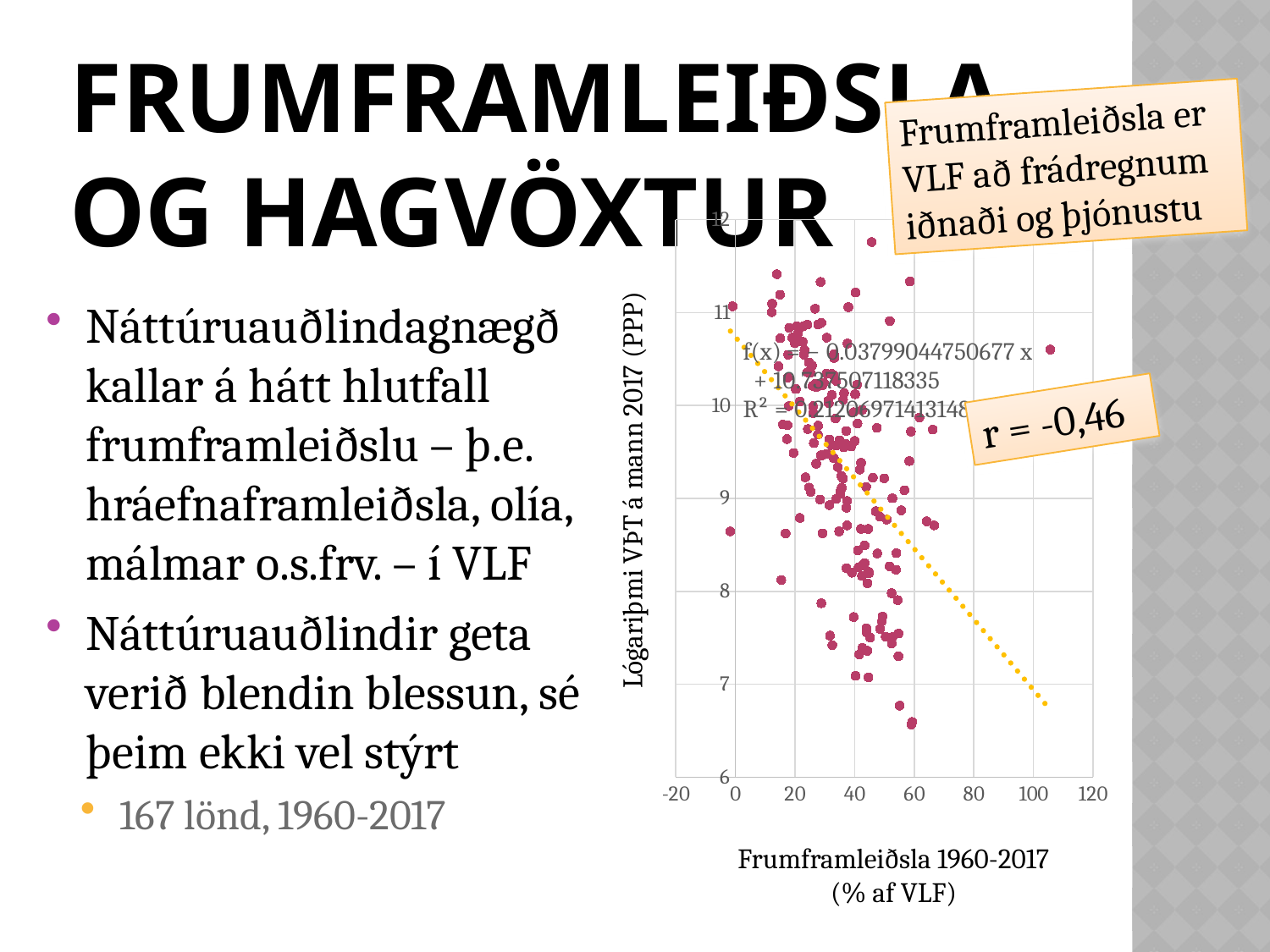
Is the y-axis value of the lowest plotted point greater or less than 7? less What kind of chart is shown on the slide? scatter chart Is the x-axis value of the rightmost plotted point greater or less than 80? greater What correlation coefficient r is shown on the slide for the chart? r = -0,46 What is the slope coefficient of x in the fitted line equation f(x) shown on the chart? -0.03799044750677 Is the y-axis value of the highest plotted point greater or less than 11? greater Do the plotted values tend to rise or fall as the x-axis value increases? fall Does the dotted trend line slope upward or downward from left to right? downward What is the title of the x axis of the chart? Frumframleiðsla 1960-2017 (% af VLF) What is the title of the y axis of the chart? Lógariþmi VÞT á mann 2017 (PPP)